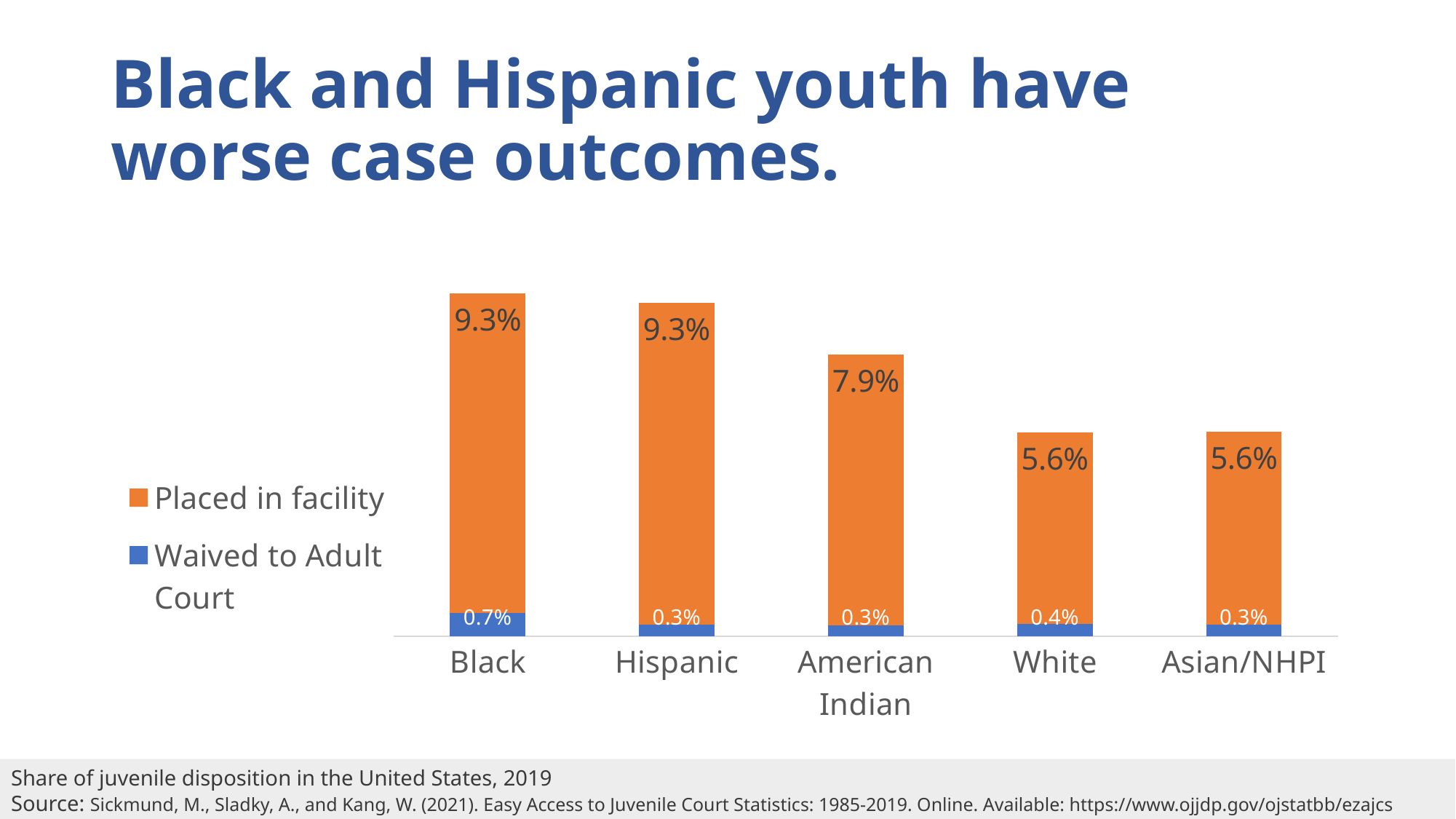
What is the Placed in facility value for White youth? 5.6% What kind of chart is shown on the slide? Stacked bar chart What is the difference between the Placed in facility values for Black and American Indian youth? 1.4 percentage points Which colour represents the Placed in facility series? Orange What is the Placed in facility value for American Indian youth? 7.9% Which is larger, the Waived to Adult Court value for Black youth or for White youth? Black How many series does the legend list? 2 Which category has the highest Waived to Adult Court value? Black How many categories are shown on the x axis? 5 What is the Waived to Adult Court value for White youth? 0.4% What is the Waived to Adult Court value for Black youth? 0.7% What is the total of the stacked bar for Black youth? 10.0%